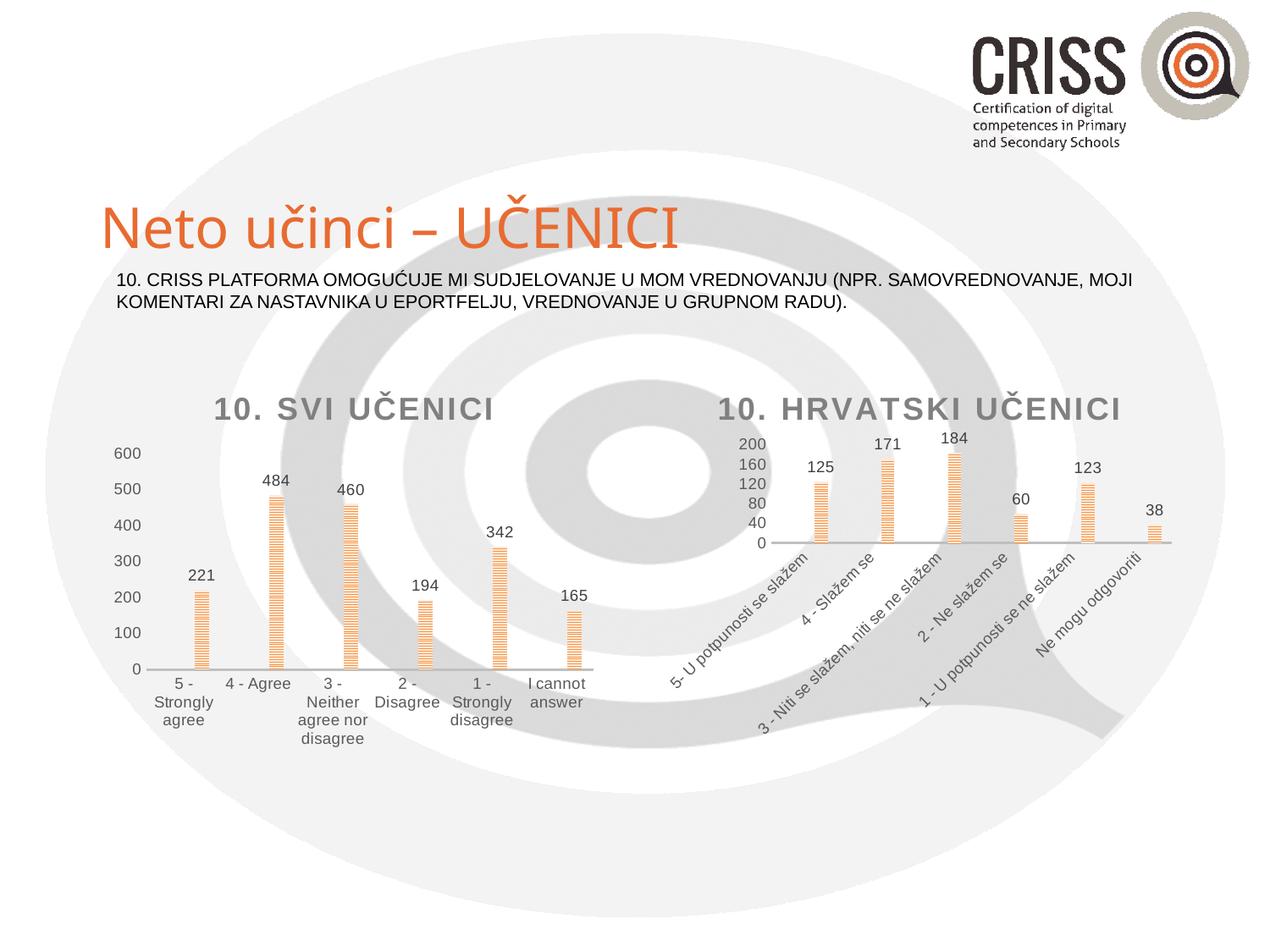
In the "10. SVI UČENICI" chart, which is larger: the value for "5 - Strongly agree" or "1 - Strongly disagree"? 1 - Strongly disagree In the "10. SVI UČENICI" chart, which category has the lowest value? I cannot answer In the "10. HRVATSKI UČENICI" chart, what is the value for "2 - Ne slažem se"? 60 What type of chart is the "10. HRVATSKI UČENICI" chart? Bar chart In the "10. SVI UČENICI" chart, what is the value for "4 - Agree"? 484 In the "10. HRVATSKI UČENICI" chart, which category has the highest value? 3 - Niti se slažem, niti se ne slažem In the "10. HRVATSKI UČENICI" chart, which category has the lowest value? Ne mogu odgovoriti In the "10. SVI UČENICI" chart, what is the value for "I cannot answer"? 165 How many categories are shown in the "10. SVI UČENICI" chart? 6 In the "10. SVI UČENICI" chart, what is the difference between the values for "4 - Agree" and "3 - Neither agree nor disagree"? 24 In the "10. SVI UČENICI" chart, which category has the highest value? 4 - Agree In the "10. HRVATSKI UČENICI" chart, what is the difference between the values for "4 - Slažem se" and "5- U potpunosti se slažem"? 46